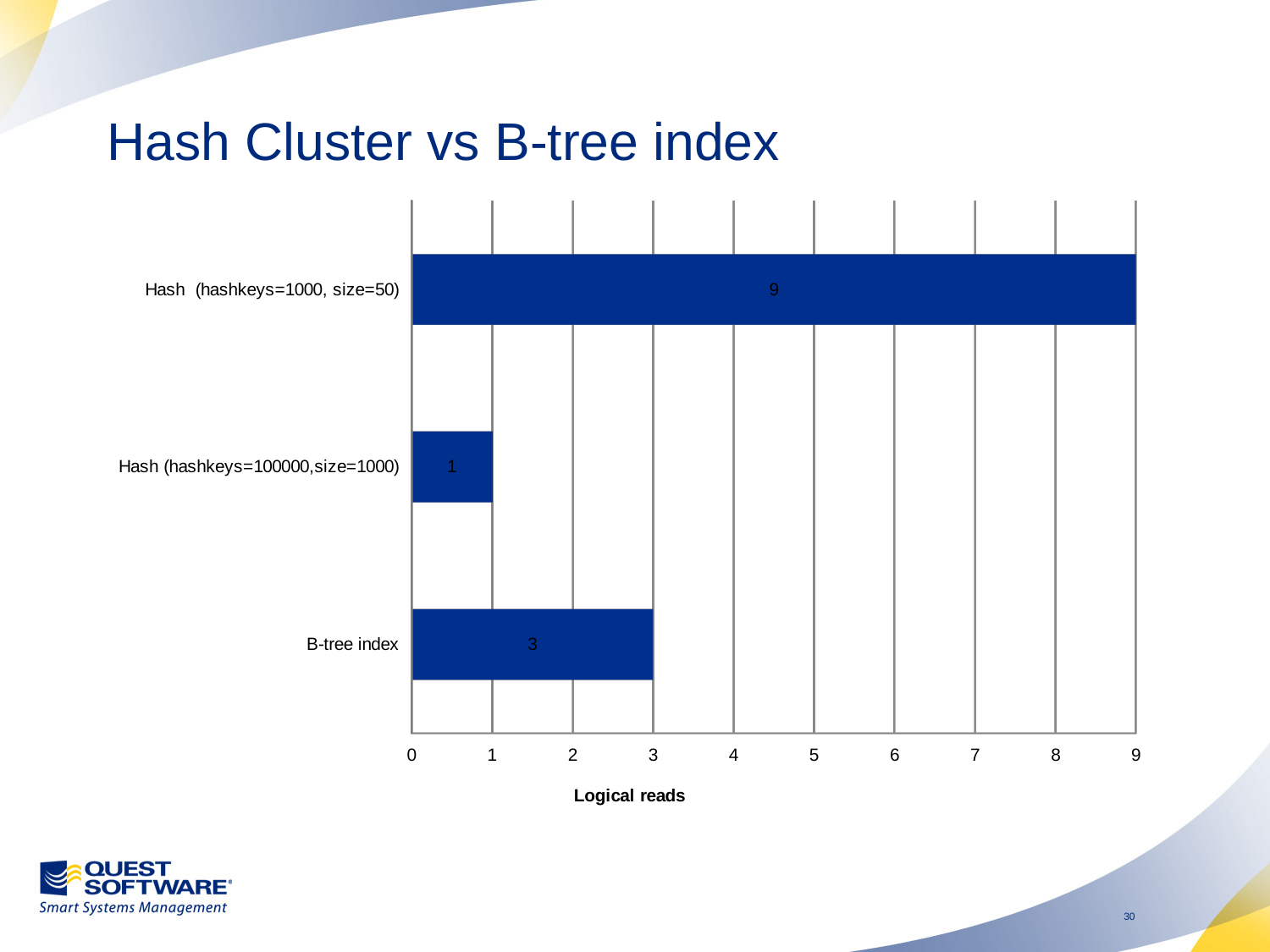
What is the label of the horizontal axis? Logical reads Which has more logical reads, B-tree index or Hash (hashkeys=100000,size=1000)? B-tree index What is the difference in logical reads between Hash (hashkeys=1000, size=50) and B-tree index? 6 What is the number of logical reads for Hash (hashkeys=100000,size=1000)? 1 Is the value for Hash (hashkeys=1000, size=50) greater or less than 5? greater What is the number of logical reads for Hash (hashkeys=1000, size=50)? 9 What is the difference in logical reads between B-tree index and Hash (hashkeys=100000,size=1000)? 2 What is the number of logical reads for B-tree index? 3 What kind of chart is shown on the slide? bar chart How many categories are shown in the chart? 3 Which category has the highest number of logical reads? Hash (hashkeys=1000, size=50) Which category has the lowest number of logical reads? Hash (hashkeys=100000,size=1000)